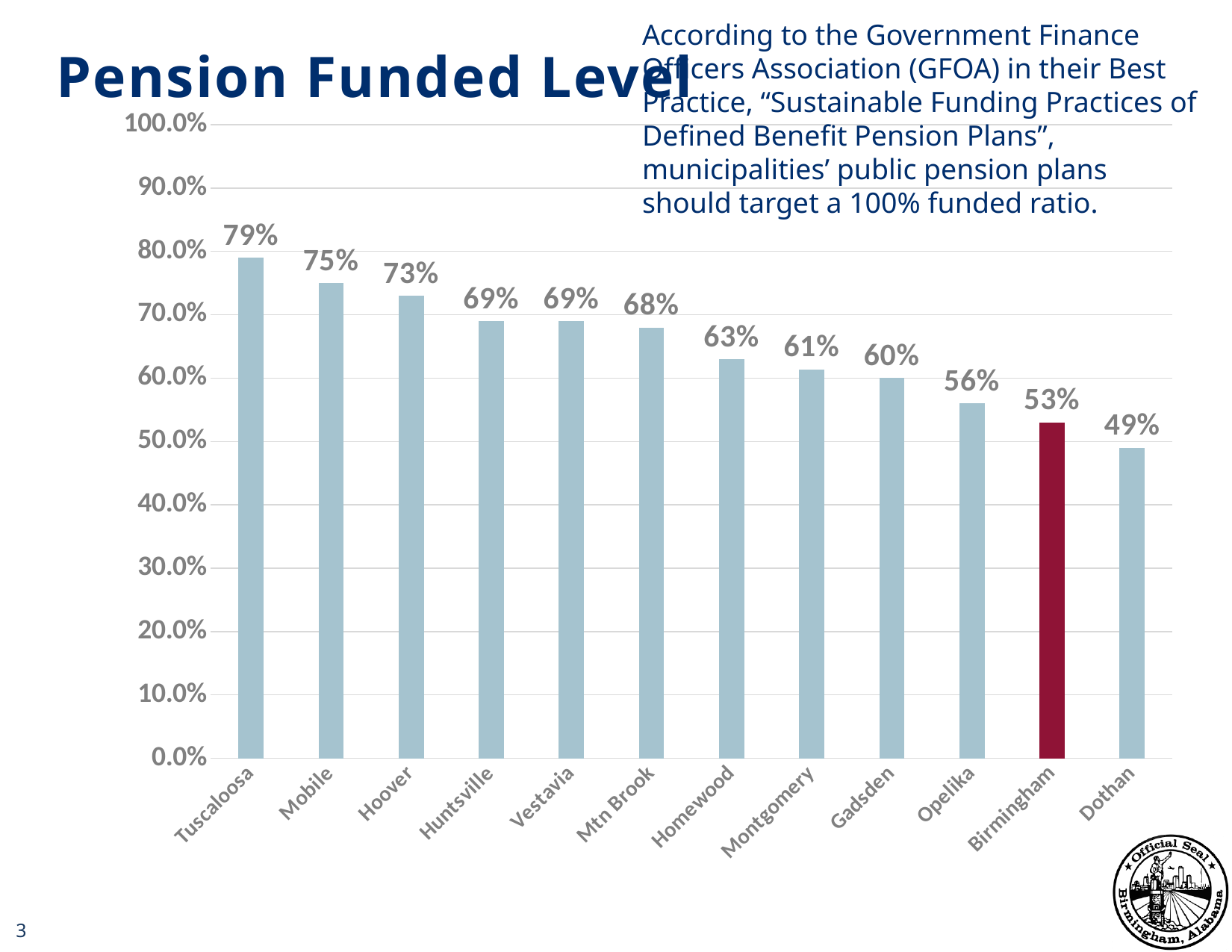
What is the pension funded level for Birmingham? 53% What is the pension funded level for Tuscaloosa? 79% Is the pension funded level for Opelika greater or less than 60.0%? less How many cities are shown in the chart? 12 Which city's bar is highlighted in a different colour (dark red) from the others? Birmingham What is the pension funded level for Montgomery? 61% What is the difference between the pension funded levels of Tuscaloosa and Dothan? 30% Which city has the highest pension funded level? Tuscaloosa Which city has the lowest pension funded level? Dothan What is the difference between the pension funded levels of Mobile and Birmingham? 22% What kind of chart is shown on the slide? Bar chart Which has a higher pension funded level, Hoover or Gadsden? Hoover